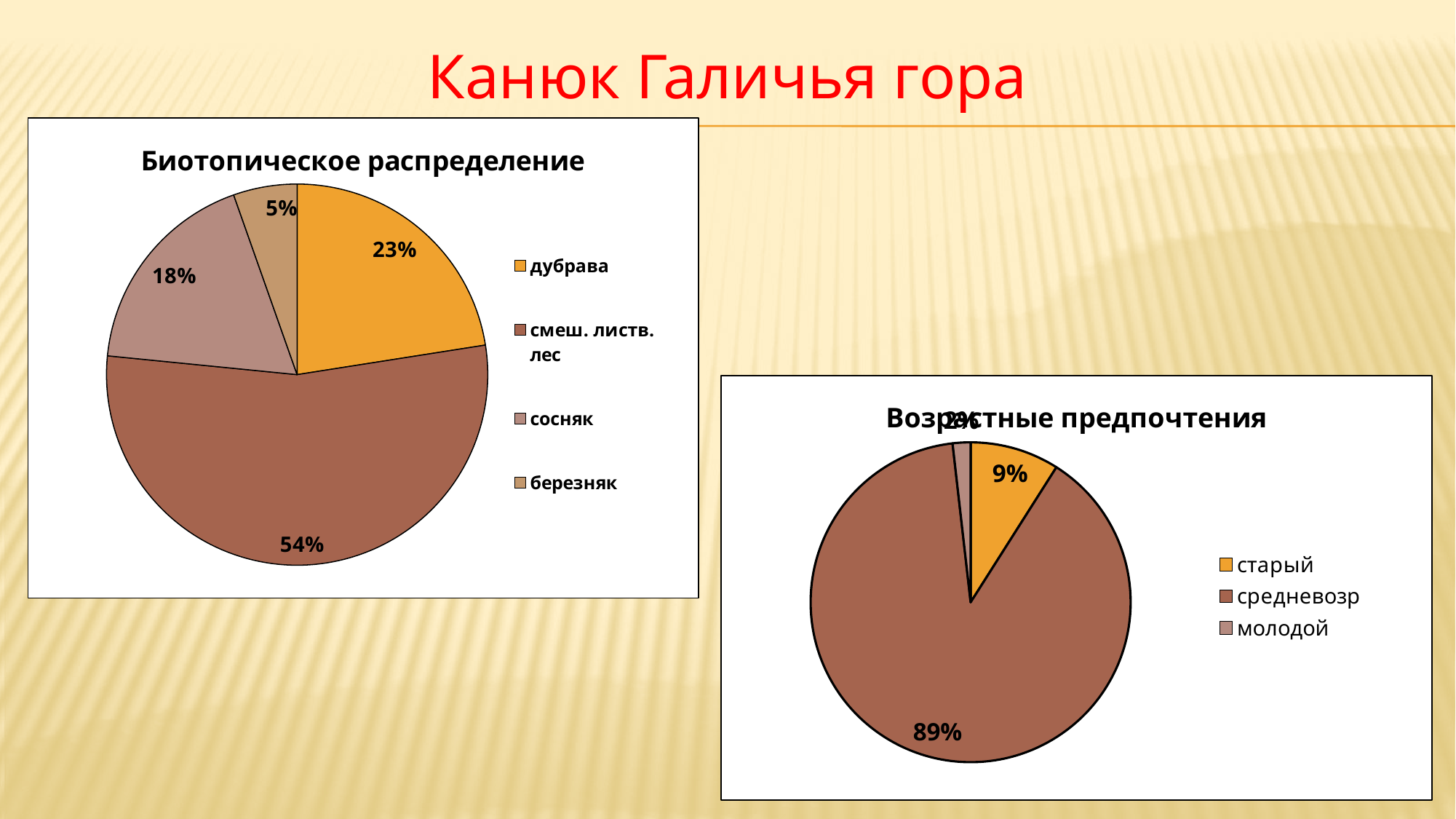
In the chart titled "Возрастные предпочтения", what share does "средневозр" have? 89% In the chart titled "Биотопическое распределение", which category has the largest slice? смеш. листв. лес In the chart titled "Биотопическое распределение", what is the difference between the shares of "дубрава" and "сосняк"? 5% In the chart titled "Возрастные предпочтения", which category has the smallest slice? молодой In the chart titled "Возрастные предпочтения", what share does "старый" have? 9% In the chart titled "Возрастные предпочтения", how many entries does the legend list? 3 What type of chart is "Возрастные предпочтения"? Pie chart In the chart titled "Биотопическое распределение", what share does "сосняк" have? 18% In the chart titled "Биотопическое распределение", how many categories are shown? 4 In the chart titled "Биотопическое распределение", what share does "дубрава" have? 23% In the chart titled "Биотопическое распределение", what share does "смеш. листв. лес" have? 54% In the chart titled "Биотопическое распределение", which category has the smallest slice? березняк